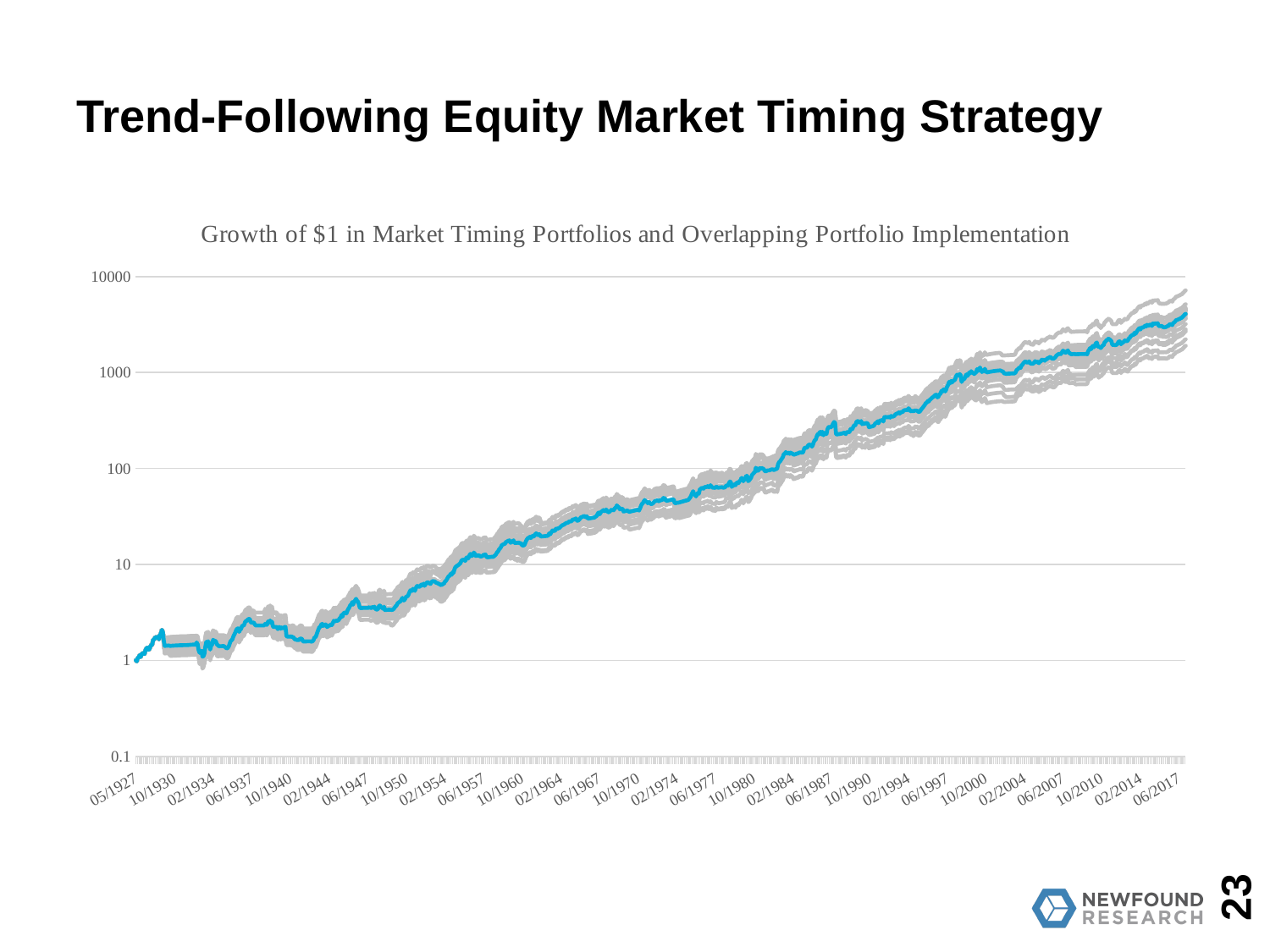
Is the value of the blue line at 10/1970 greater or less than 100? less Is the value of the blue line at 06/2017 greater or less than 1000? greater What is the title of the chart? Growth of $1 in Market Timing Portfolios and Overlapping Portfolio Implementation Is the value of the blue line at 06/2017 greater or less than 10000? less Do the plotted values generally rise or fall from 05/1927 to 06/2017? rise What kind of chart is shown on the slide? line chart What is the highest value labelled on the y axis? 10000